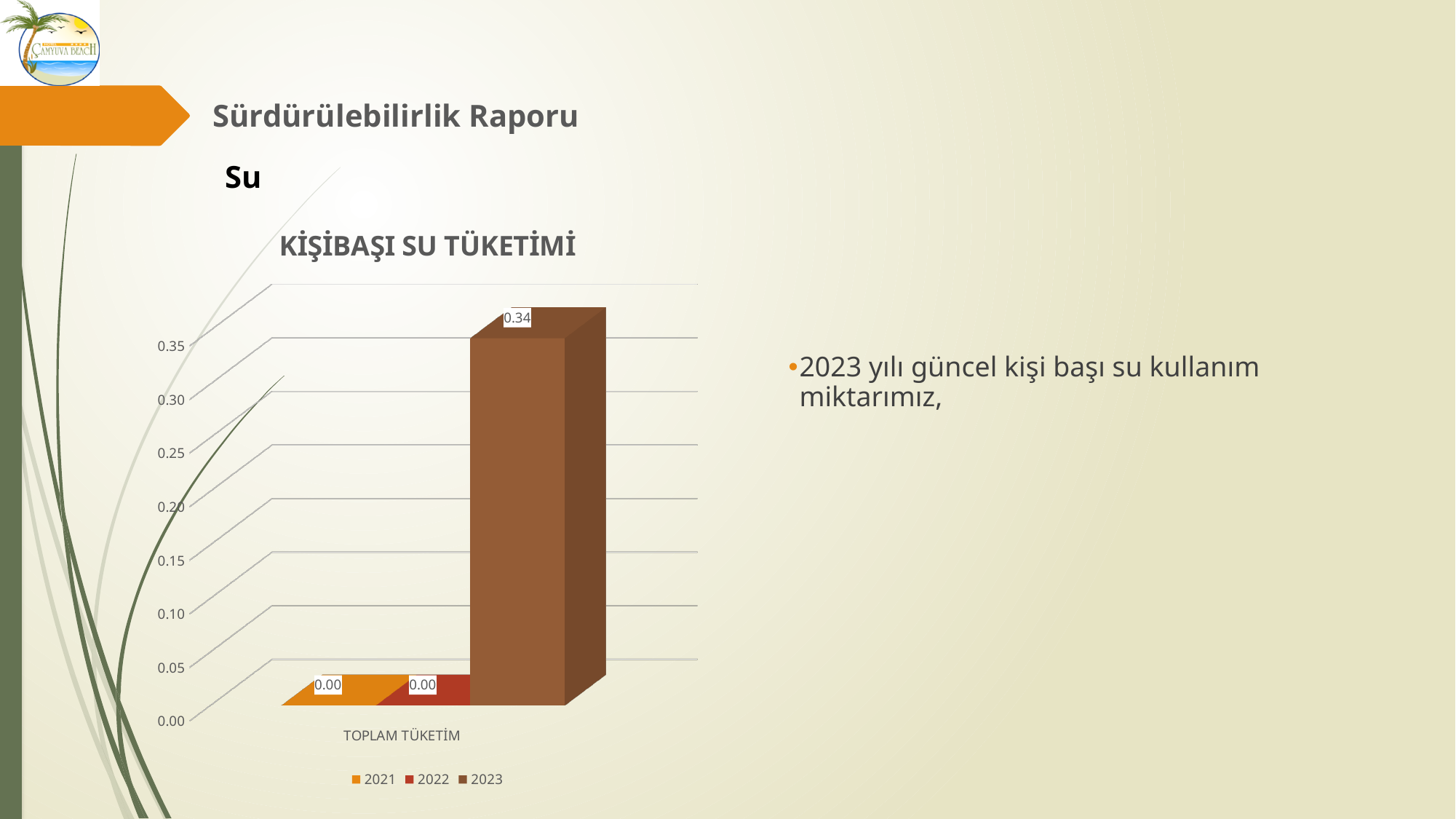
What is the category label on the x axis of the KİŞİBAŞI SU TÜKETİMİ chart? TOPLAM TÜKETİM What is the title of the chart on the slide? KİŞİBAŞI SU TÜKETİMİ Which series has the highest value in the KİŞİBAŞI SU TÜKETİMİ chart? 2023 What is the value for the 2023 series in the KİŞİBAŞI SU TÜKETİMİ chart? 0.34 Which is larger in the KİŞİBAŞI SU TÜKETİMİ chart, the 2023 value or the 2021 value? 2023 How many categories are shown on the x axis of the KİŞİBAŞI SU TÜKETİMİ chart? 1 What is the difference between the 2023 value and the 2022 value in the KİŞİBAŞI SU TÜKETİMİ chart? 0.34 How many series does the legend of the KİŞİBAŞI SU TÜKETİMİ chart list? 3 What is the value for the 2021 series in the KİŞİBAŞI SU TÜKETİMİ chart? 0.00 Is the value for 2023 in the KİŞİBAŞI SU TÜKETİMİ chart greater or less than 0.30? greater What kind of chart is the KİŞİBAŞI SU TÜKETİMİ chart? Bar chart What is the value for the 2022 series in the KİŞİBAŞI SU TÜKETİMİ chart? 0.00